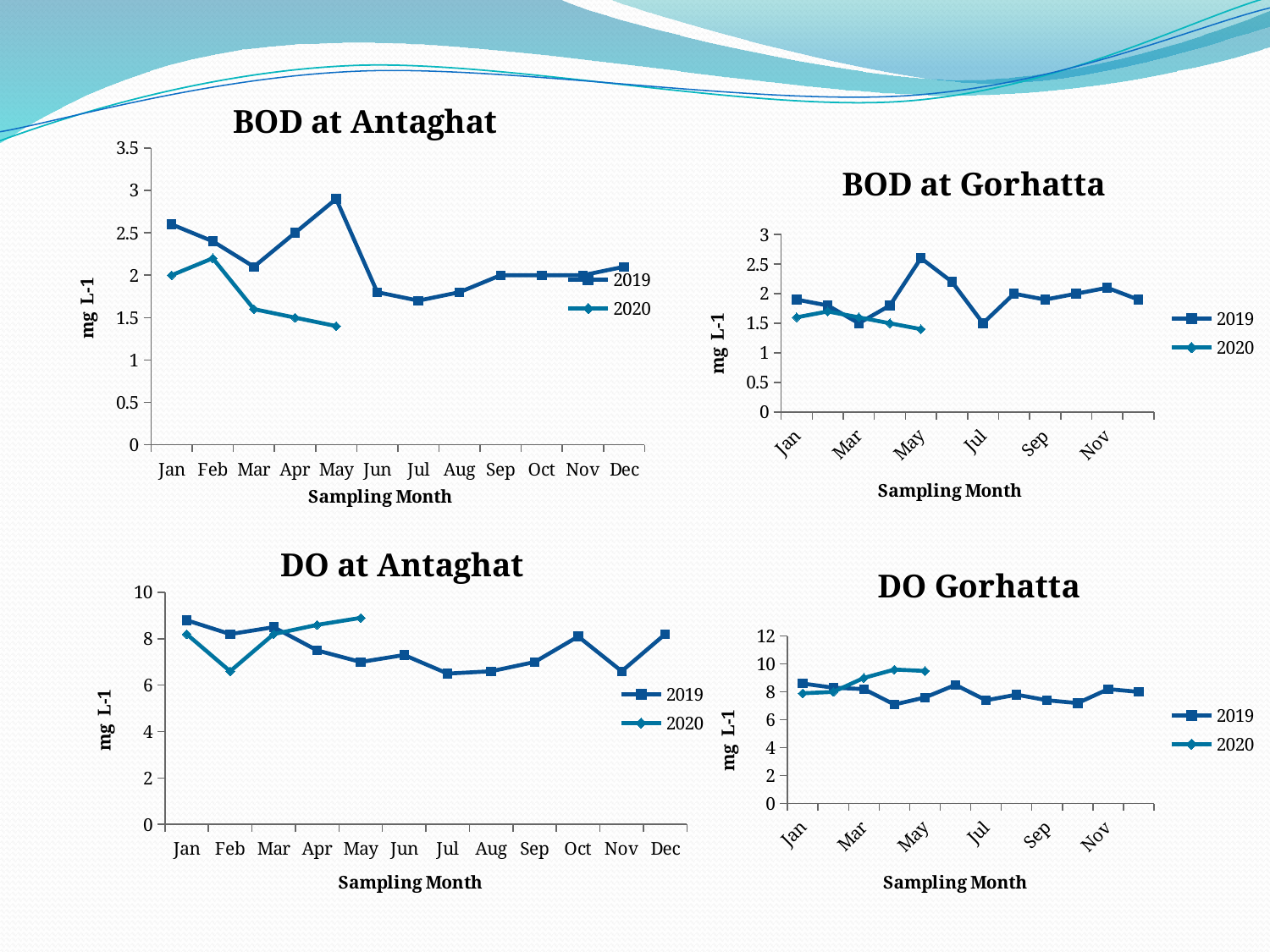
In "BOD at Antaghat", which is larger for Jan: the 2019 value or the 2020 value? 2019 How many series does the legend of "BOD at Gorhatta" list? 2 In "BOD at Antaghat", is the 2019 value for May greater or less than 2.5? greater In "BOD at Gorhatta", which month has the highest 2019 value? May In "BOD at Antaghat", is the 2020 value for May greater or less than 1.5? less How many months are shown on the x axis of "BOD at Antaghat"? 12 In "DO Gorhatta", is the 2020 value for Apr greater or less than 8? greater In "BOD at Antaghat", which month has the highest 2019 value? May What kind of chart is "BOD at Antaghat"? line chart What is the x-axis title of the "DO Gorhatta" chart? Sampling Month